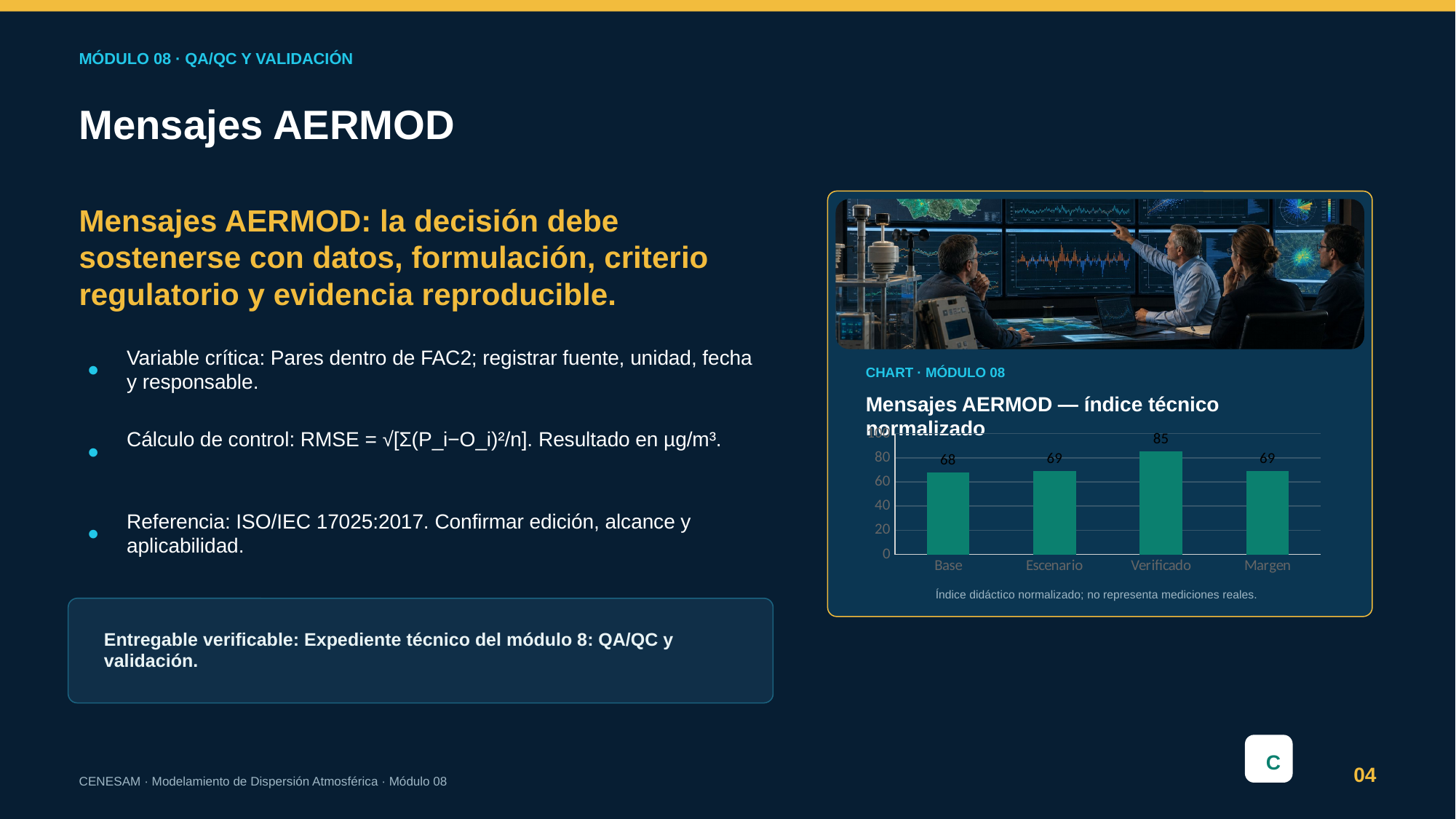
Which is larger, the value for Verificado or the value for Margen? Verificado How many categories are shown on the x axis? 4 Which category has the lowest value? Base What is the title of the chart? Mensajes AERMOD — índice técnico normalizado What is the value for Base? 68 What is the value for Verificado? 85 Which category has the highest value? Verificado What is the difference between the values for Verificado and Base? 17 What is the value for Escenario? 69 What kind of chart is shown on the slide? bar chart What is the value for Margen? 69 Is the value for Verificado greater or less than 80? greater